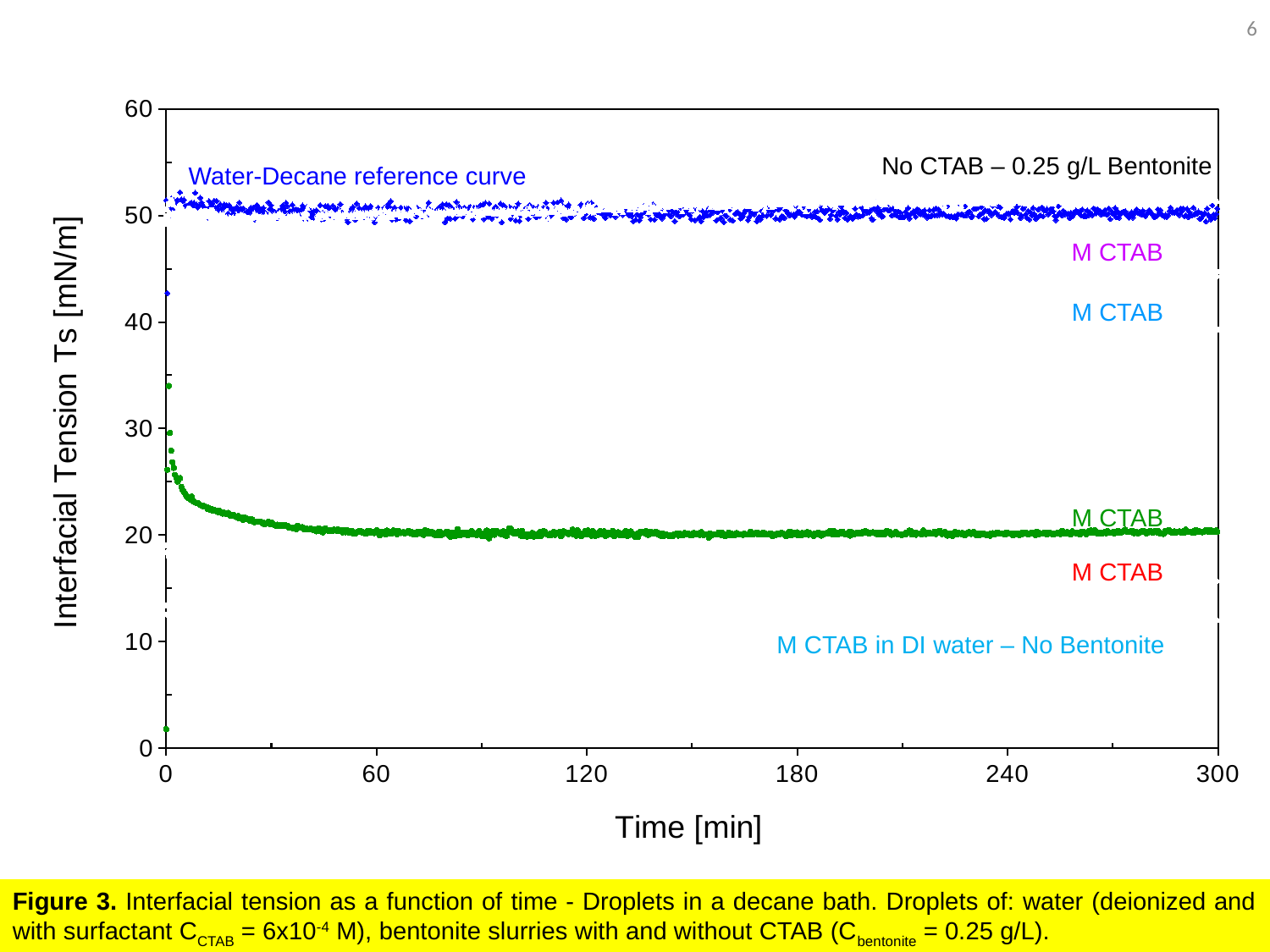
What is the label of the x axis? Time [min] What is the label of the y axis? Interfacial Tension Ts [mN/m] Is the value of the blue 'Water-Decane reference curve' at 60 min greater or less than 60 mN/m? less What kind of chart is shown on the slide? scatter chart Is the value of the blue 'Water-Decane reference curve' at 300 min greater or less than 40 mN/m? greater What is the maximum value shown on the x axis? 300